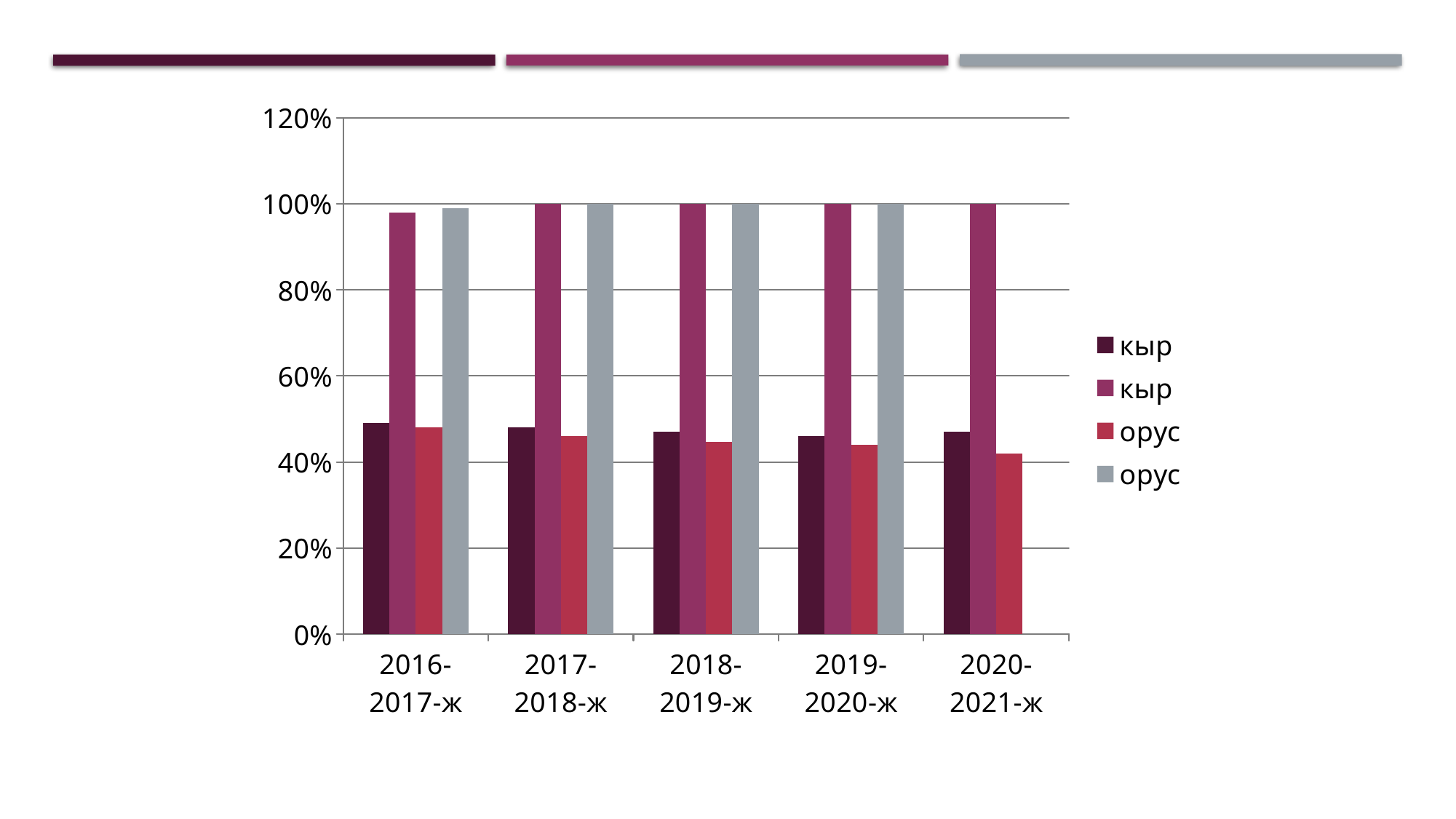
Do the values of the red орус series rise or fall from 2016-2017-ж to 2020-2021-ж? fall For 2016-2017-ж, which is larger: the magenta кыр bar or the dark purple кыр bar? the magenta кыр bar Is the value of the grey орус series for 2016-2017-ж greater or less than 80%? greater What is the label of the last entry in the legend? орус Is the value of the red орус series for 2020-2021-ж greater or less than 60%? less How many series does the legend list? 4 What kind of chart is shown on the slide? bar chart Is the value of the dark purple кыр series for 2016-2017-ж greater or less than 40%? greater How many categories (academic years) are shown on the x axis? 5 How many bars are shown for the 2020-2021-ж category? 3 Which is larger: the red орус bar for 2020-2021-ж or the grey орус bar for 2019-2020-ж? the grey орус bar for 2019-2020-ж